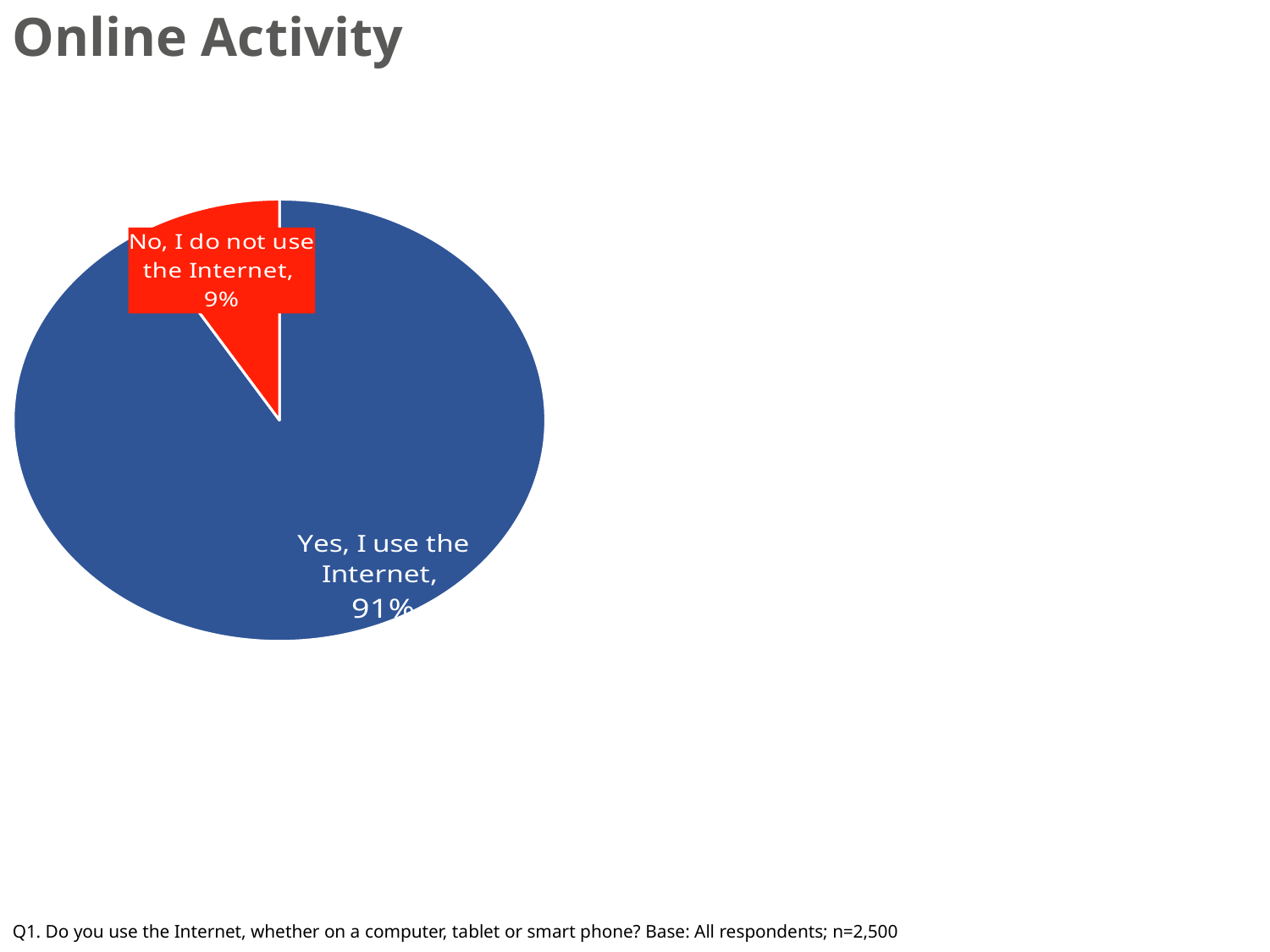
How many slices does the pie chart have? 2 What percentage of respondents say they do not use the Internet? 9% What share of the pie does the 'No, I do not use the Internet' slice represent? 9% What is the title of the slide? Online Activity Which category has the smallest share of the pie? No, I do not use the Internet What percentage of respondents say they use the Internet? 91% What colour is the slice for 'No, I do not use the Internet'? Red What kind of chart is shown on the slide? Pie chart Which is larger: the share who use the Internet or the share who do not? Yes, I use the Internet Is the share for 'Yes, I use the Internet' greater or less than 50%? greater Which category has the largest share of the pie? Yes, I use the Internet What is the difference in percentage points between those who use the Internet and those who do not? 82